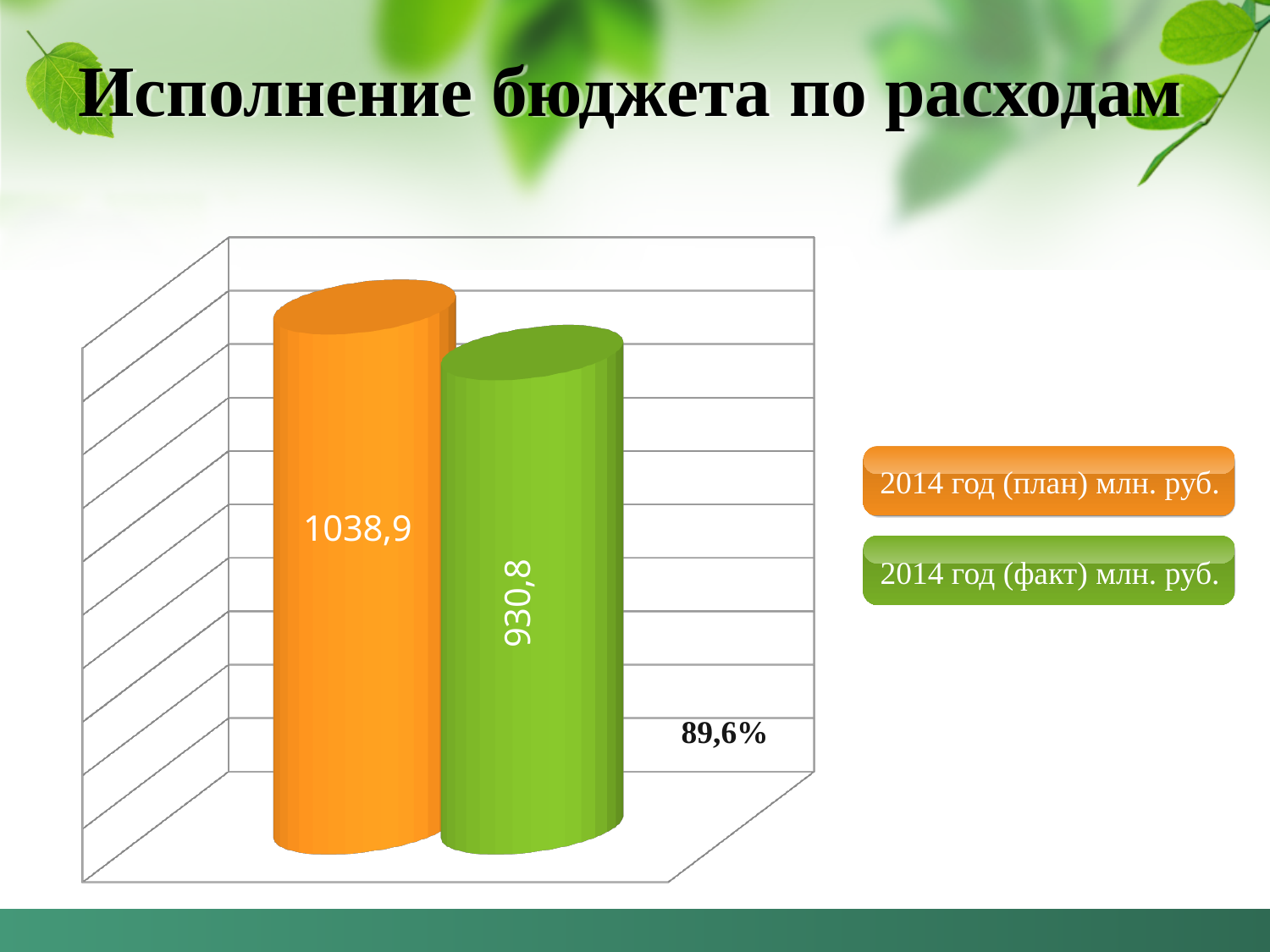
What is the value shown for 2014 год (план) млн. руб.? 1038,9 What is the title of the slide? Исполнение бюджета по расходам Which series has the higher value, the plan or the fact for 2014? 2014 год (план) млн. руб. Is the value for 2014 год (факт) larger or smaller than the value for 2014 год (план)? smaller What percentage is printed on the chart next to the bars? 89,6% How many series does the legend list? 2 What is the difference between the 2014 plan value and the 2014 fact value? 108,1 How many bars are plotted on the chart? 2 What kind of chart is shown on the slide? bar chart Which series has the lower value on the chart? 2014 год (факт) млн. руб. What is the value shown for 2014 год (факт) млн. руб.? 930,8